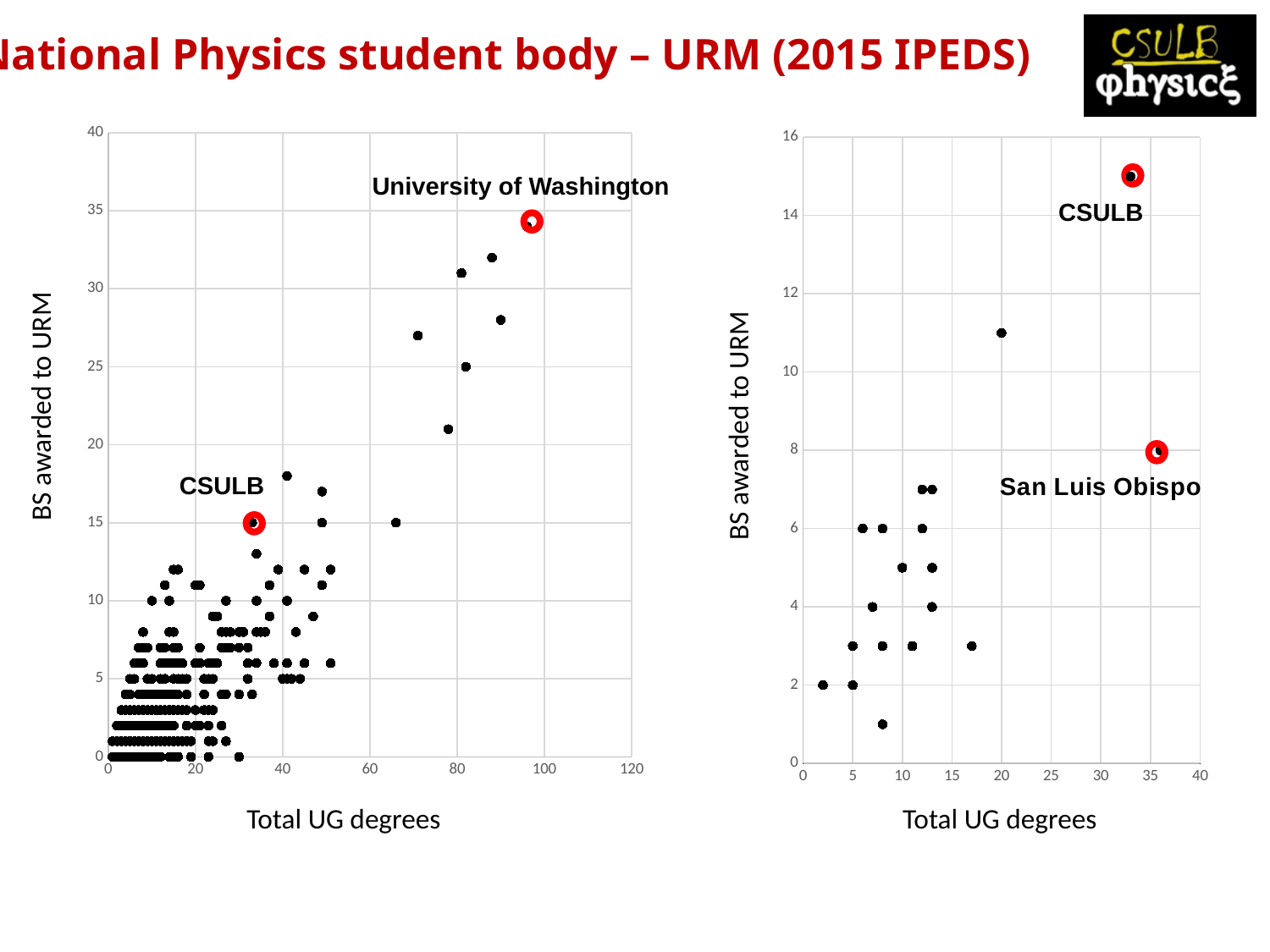
On the left chart, is the Total UG degrees value for University of Washington greater or less than 80? greater What is the y-axis title of the right chart? BS awarded to URM What is the x-axis title of the left chart? Total UG degrees On the right chart, is the value of BS awarded to URM for San Luis Obispo greater or less than 10? less On the right chart, is the value of BS awarded to URM for CSULB greater or less than 14? greater On the right chart, which point has the highest value of BS awarded to URM? CSULB What kind of chart is the left chart on the slide? scatter chart On the left chart, which labeled point has more BS awarded to URM, University of Washington or CSULB? University of Washington What kind of chart is the right chart on the slide? scatter chart On the right chart, which labeled point has more BS awarded to URM, CSULB or San Luis Obispo? CSULB